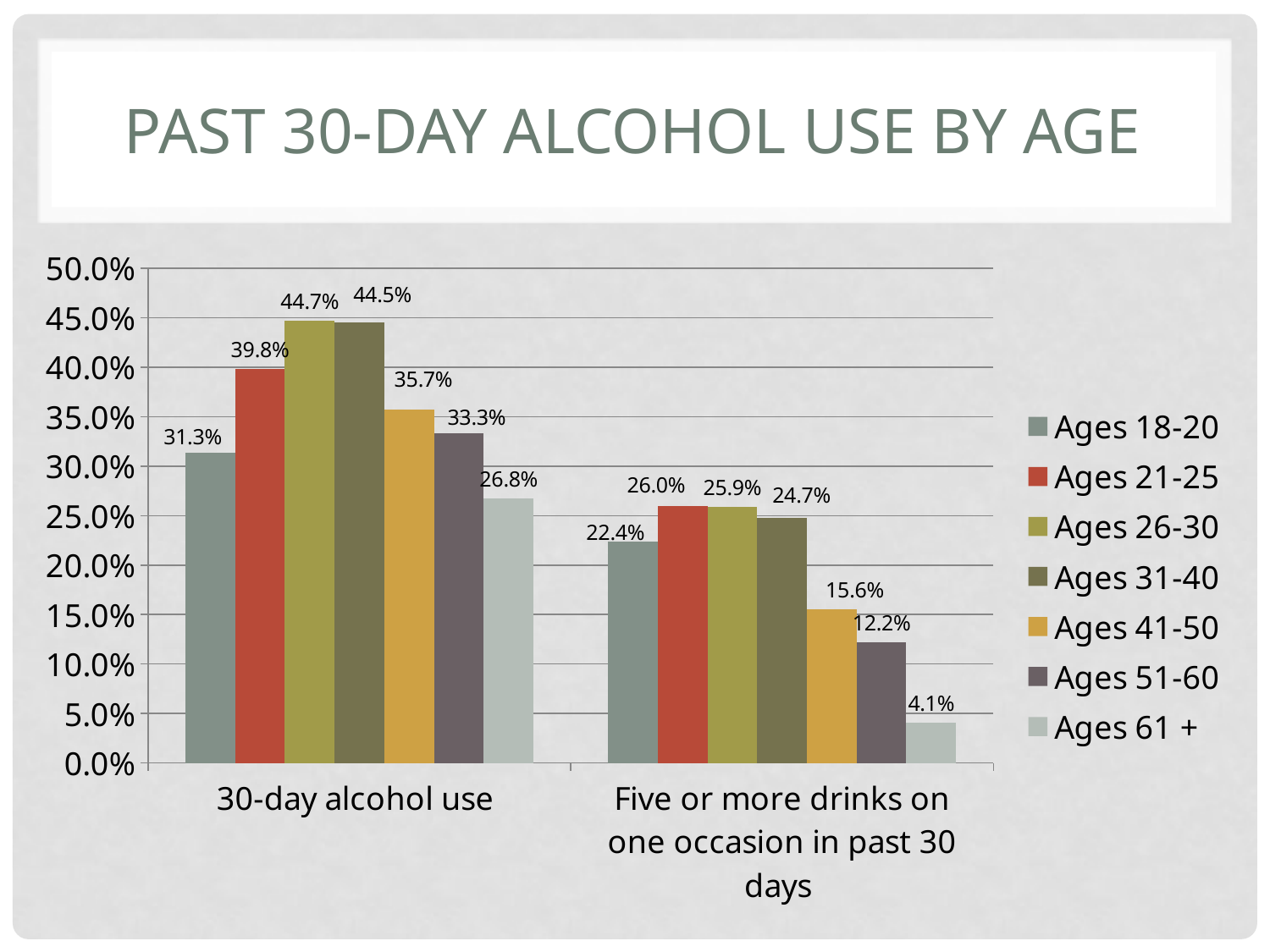
How many series does the legend list? 7 What is the value for Ages 26-30 in the 30-day alcohol use category? 44.7% Which is larger for Five or more drinks on one occasion in past 30 days: Ages 41-50 or Ages 51-60? Ages 41-50 What is the title of the slide? Past 30-Day Alcohol Use by Age How many categories are shown on the x axis? 2 What is the difference between the Ages 21-25 and Ages 18-20 values for 30-day alcohol use? 8.5% Is the value for Ages 51-60 in the 30-day alcohol use category greater or less than 30.0%? greater Which age group has the highest value for 30-day alcohol use? Ages 26-30 Which age group has the lowest value for Five or more drinks on one occasion in past 30 days? Ages 61 + What kind of chart is shown on the slide? Bar chart What is the value for Ages 41-50 in the 30-day alcohol use category? 35.7% What is the value for Ages 61 + in the Five or more drinks on one occasion in past 30 days category? 4.1%